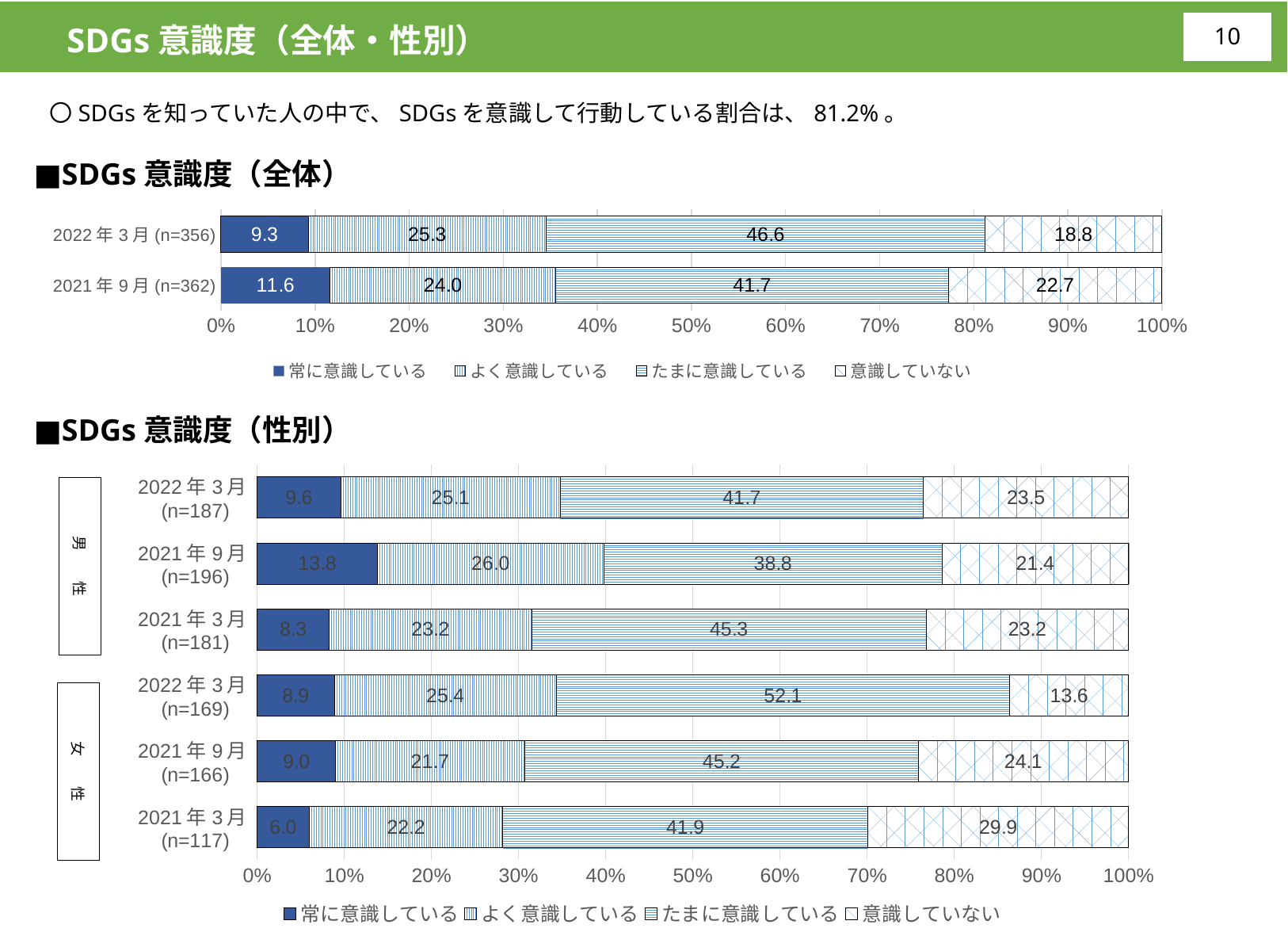
How many bars are plotted in the SDGs 意識度（性別） chart? 6 In the SDGs 意識度（全体） chart, what is the difference between the 意識していない values for 2021年9月 and 2022年3月? 3.9 What kind of chart is the SDGs 意識度（性別） chart? Stacked bar chart In the SDGs 意識度（全体） chart, which year has the larger value for 常に意識している, 2022年3月 or 2021年9月? 2021年9月 In the SDGs 意識度（性別） chart, which bar has the lowest value for 意識していない? 女性 2022年3月 (n=169) In the SDGs 意識度（性別） chart, which bar has the highest value for 常に意識している? 男性 2021年9月 (n=196) In the SDGs 意識度（性別） chart, what is the value for 意識していない for 女性 2021年3月 (n=117)? 29.9 In the SDGs 意識度（全体） chart, what is the value for 常に意識している in 2022年3月 (n=356)? 9.3 In the SDGs 意識度（全体） chart, what is the value for たまに意識している in 2021年9月 (n=362)? 41.7 How many series does the legend of the SDGs 意識度（全体） chart list? 4 In the SDGs 意識度（性別） chart, what is the value for たまに意識している for 女性 2022年3月 (n=169)? 52.1 In the SDGs 意識度（性別） chart, what is the difference between the よく意識している values for 男性 2021年9月 and 男性 2021年3月? 2.8